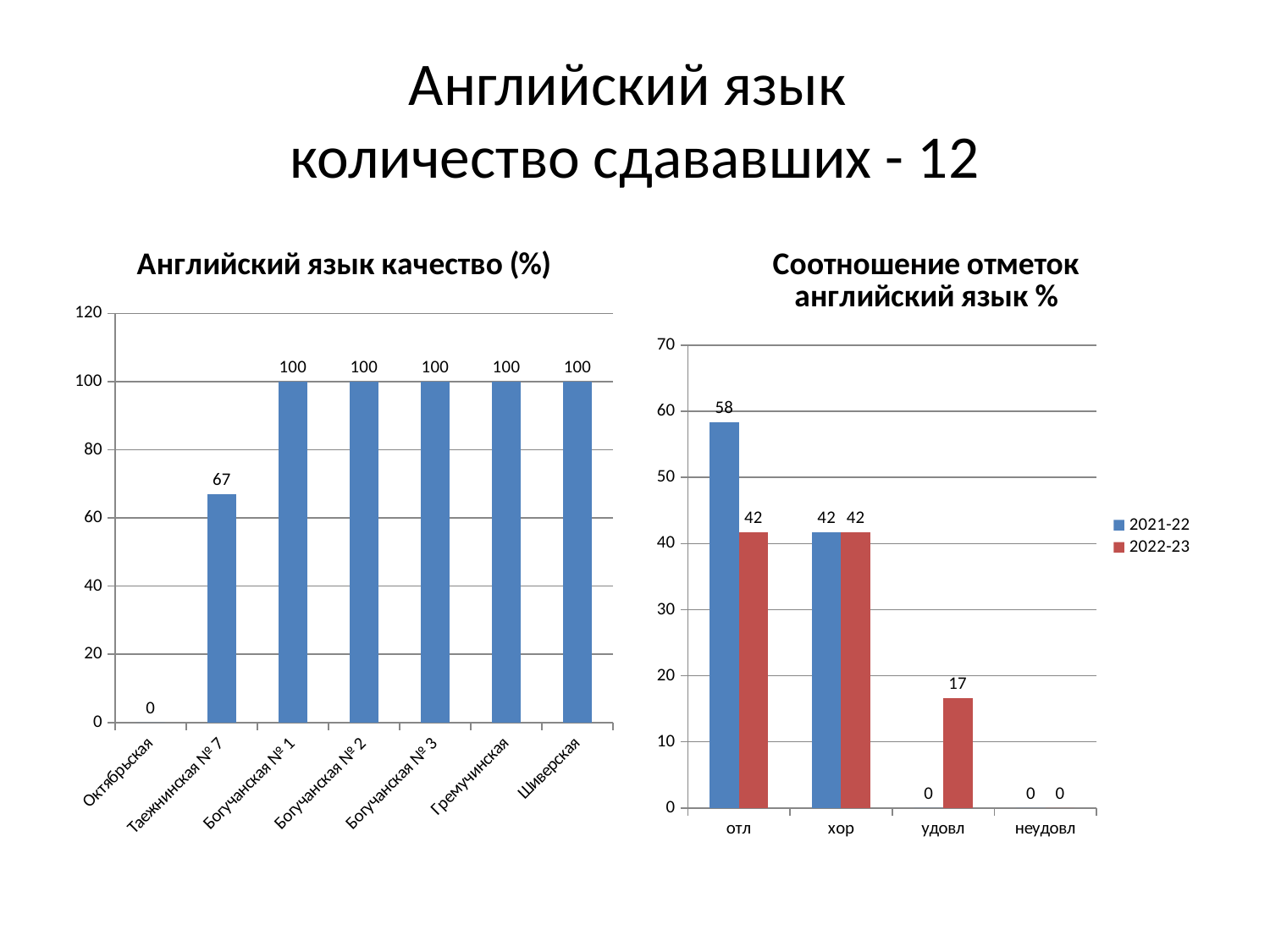
In the chart 'Английский язык качество (%)', what is the difference between the values for Богучанская № 1 and Таежнинская № 7? 33 In the chart 'Английский язык качество (%)', which category has the lowest value? Октябрьская In the chart 'Соотношение отметок английский язык %', what is the difference between the 2021-22 and 2022-23 values for отл? 16 In the chart 'Соотношение отметок английский язык %', what is the value for отл in 2021-22? 58 In the chart 'Соотношение отметок английский язык %', what is the value for удовл in 2022-23? 17 In the chart 'Соотношение отметок английский язык %', which series is shown in red? 2022-23 What kind of chart is 'Соотношение отметок английский язык %'? Bar chart In the chart 'Соотношение отметок английский язык %', which is larger for отл: the 2021-22 value or the 2022-23 value? 2021-22 In the chart 'Английский язык качество (%)', what is the value for Октябрьская? 0 In the chart 'Английский язык качество (%)', what is the value for Таежнинская № 7? 67 In the chart 'Соотношение отметок английский язык %', how many series does the legend list? 2 In the chart 'Английский язык качество (%)', how many categories are shown on the x axis? 7